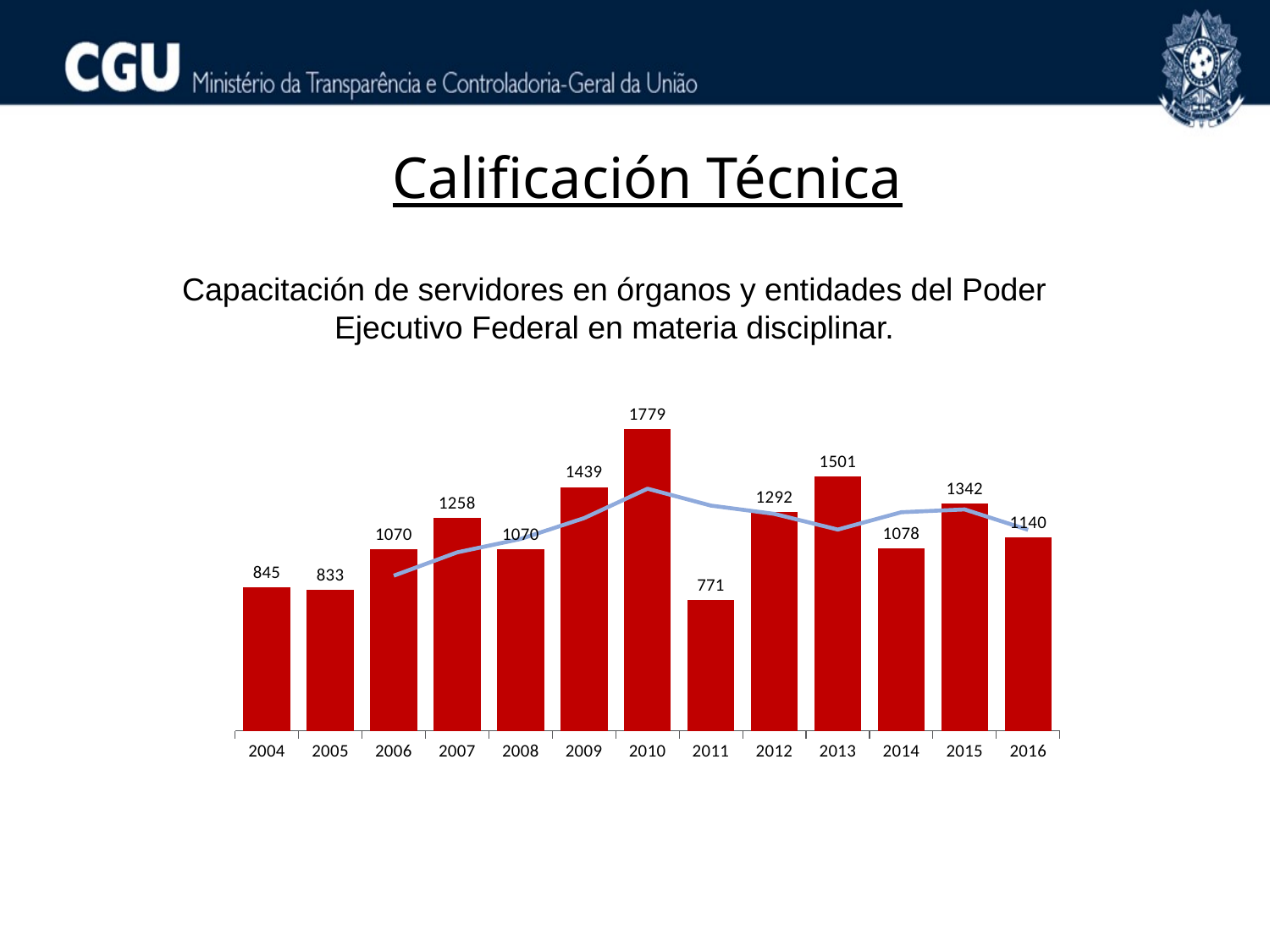
What is the difference between the values for 2010 and 2011? 1008 Which year has the highest value? 2010 Do the values rise or fall from 2004 to 2010? Rise How many years are shown on the x axis? 13 What is the value for 2013? 1501 Which year has the lowest value? 2011 Which is larger, the value for 2009 or the value for 2012? 2009 What kind of chart is shown on the slide? Bar chart What is the difference between the values for 2015 and 2014? 264 What is the value for 2004? 845 What is the value for 2016? 1140 What is the value for 2010? 1779